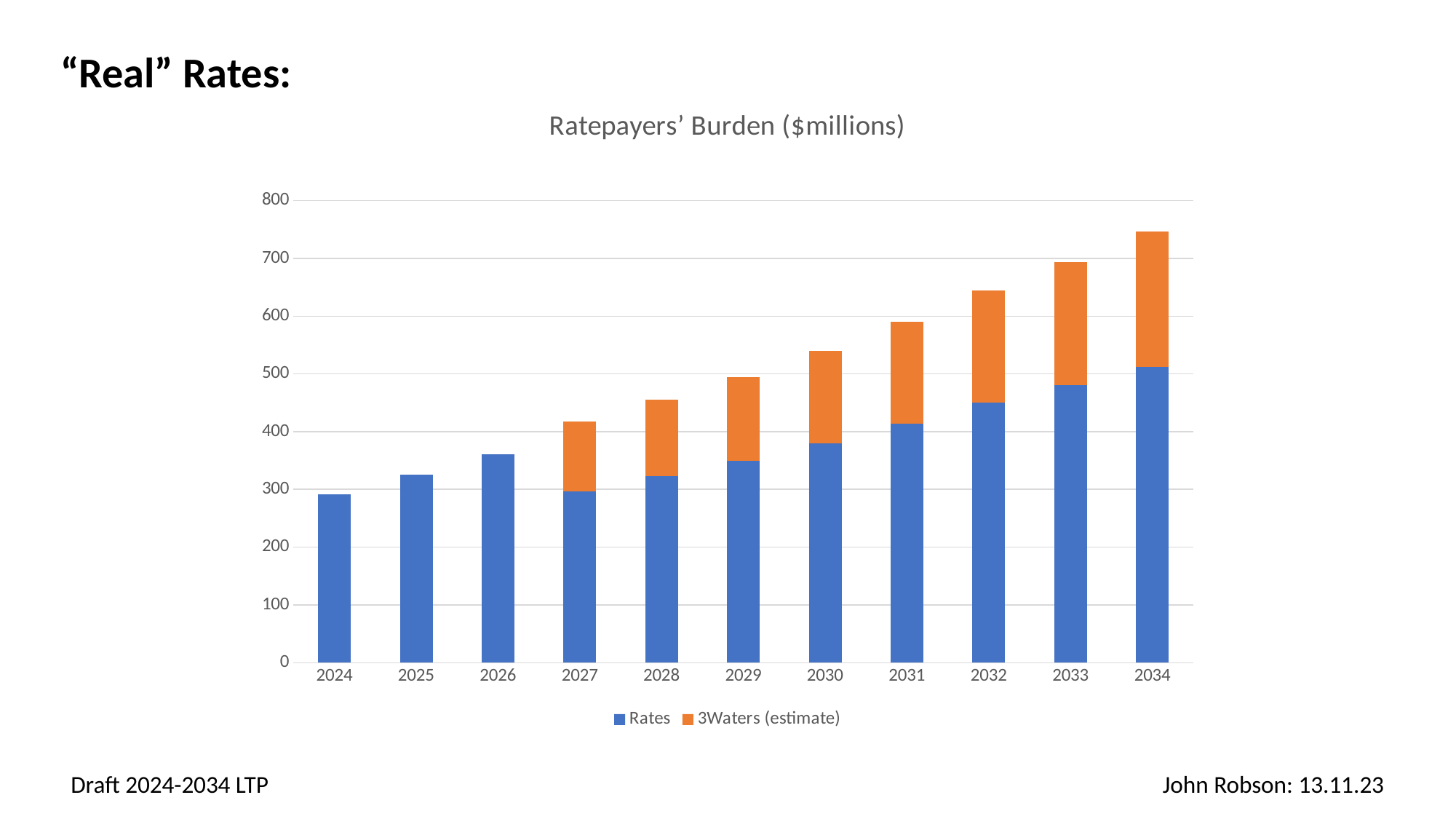
Which year has the highest total bar? 2034 Is the total bar for 2032 greater or less than 600? greater Do the total bar heights rise or fall from 2024 to 2034? rise Which series is shown in orange? 3Waters (estimate) How many years are shown on the x axis? 11 How many series does the legend list? 2 What is the title of the chart? Ratepayers' Burden ($millions) Is the Rates value for 2024 greater or less than 300? less Which year has the lowest total bar? 2024 Is the Rates value for 2026 greater or less than 400? less What kind of chart is shown on the slide? bar chart